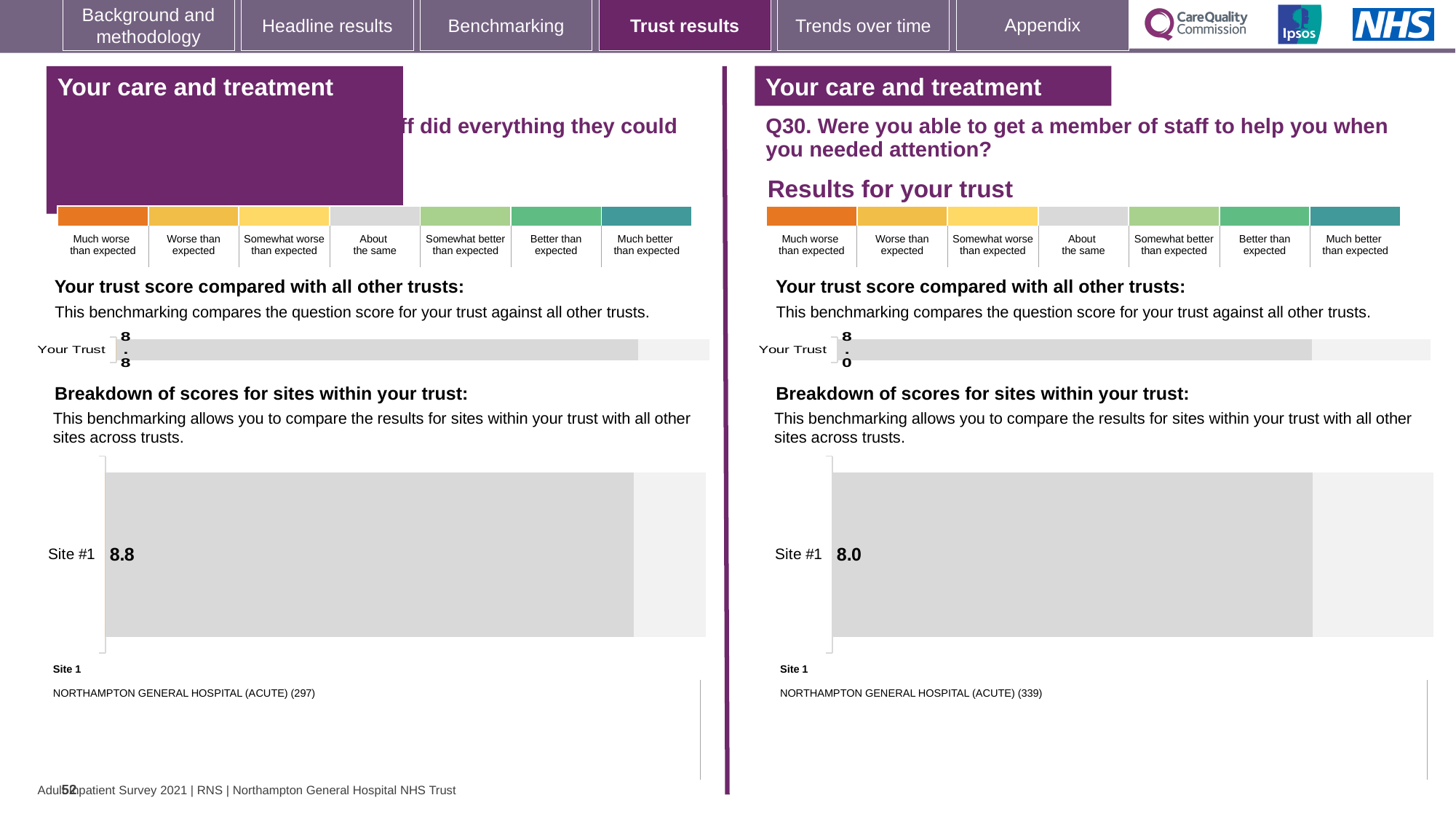
On the left-hand chart, what is the score for Site #1? 8.8 On the left-hand chart, how many respondents are shown in brackets for Site 1, Northampton General Hospital (Acute)? 297 What is the difference between the Site #1 score on the left-hand chart and the Site #1 score on the right-hand chart (Q30)? 0.8 On the right-hand chart (Q30), which site is listed as Site 1? NORTHAMPTON GENERAL HOSPITAL (ACUTE) (339) On the right-hand chart (Q30), is the Site #1 score greater or less than 8.5? less On the right-hand chart (Q30), what is the score for Site #1? 8.0 How many sites are shown in the site breakdown chart on the left-hand side? 1 What kind of chart is used to show the Site #1 score on the right-hand chart (Q30)? Bar chart On the left-hand chart, what is the score shown for Your Trust? 8.8 On the right-hand chart (Q30), what is the score shown for Your Trust? 8.0 Which is larger: the Your Trust score on the left-hand chart or the Your Trust score on the right-hand chart (Q30)? Left-hand chart